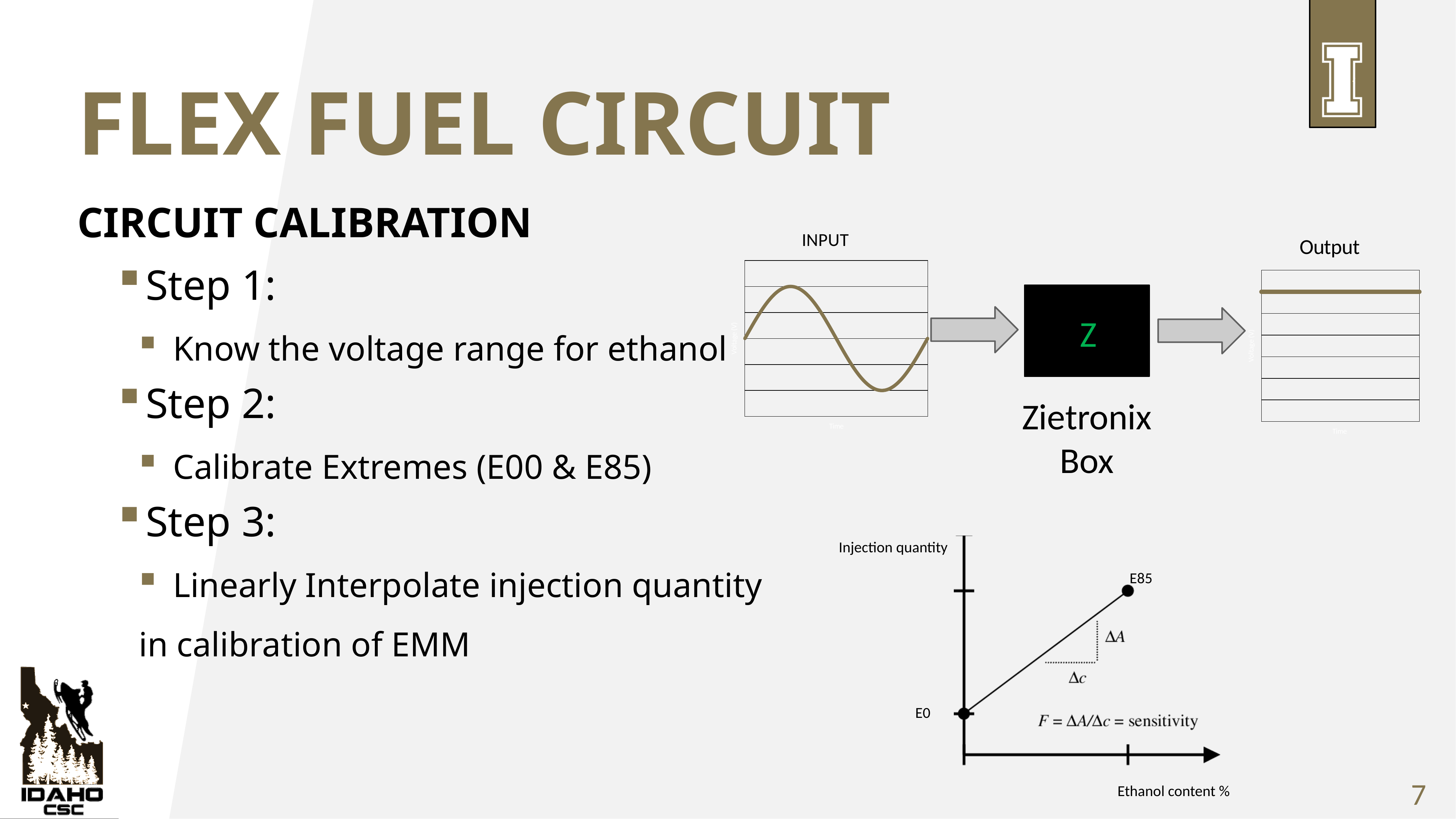
In the bottom-right injection quantity diagram, is the injection quantity larger at E0 or at E85? E85 In the bottom-right diagram, what is the label on the vertical axis? Injection quantity In the bottom-right injection quantity diagram, which labelled point has the higher injection quantity? E85 In the bottom-right diagram, what is the label on the horizontal axis? Ethanol content % What kind of chart is the INPUT chart on the slide? line chart In the bottom-right injection quantity diagram, which labelled point has the lower injection quantity? E0 In the bottom-right injection quantity diagram, does injection quantity rise or fall as ethanol content increases? rise In the INPUT chart, what shape does the plotted line follow over time? a sine wave In the bottom-right injection quantity diagram, how many labelled data points are plotted? 2 What kind of chart is the Output chart on the slide? line chart In the Output chart, does the plotted line rise, fall, or stay flat over time? stay flat